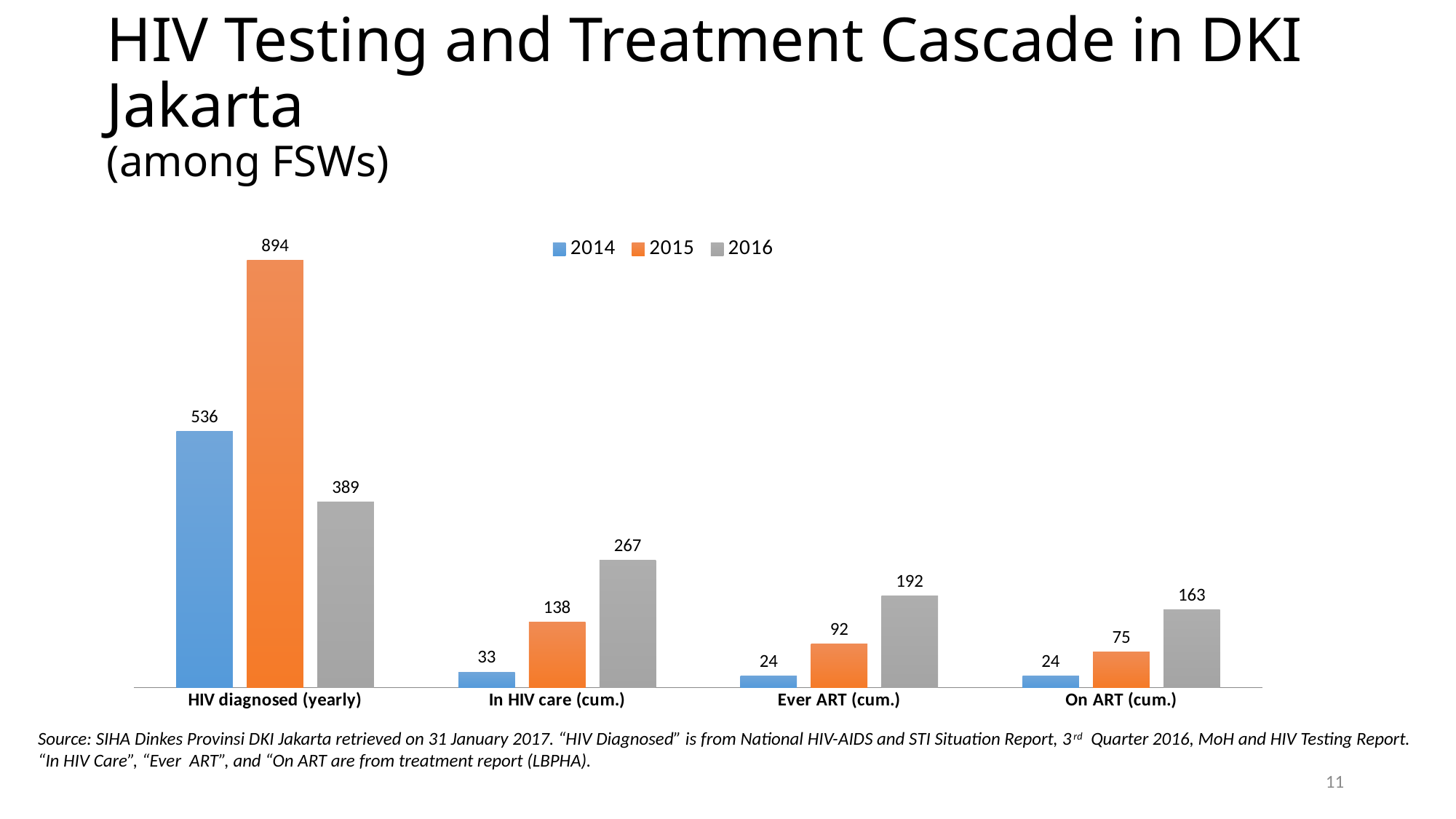
What is the value for 2016 in the In HIV care (cum.) category? 267 What is the difference between the 2015 and 2014 values in the HIV diagnosed (yearly) category? 358 What is the value for 2015 in the HIV diagnosed (yearly) category? 894 Which year has the lowest value in the Ever ART (cum.) category? 2014 How many categories are shown on the x axis? 4 What kind of chart is shown on the slide? Bar chart Which is larger: the 2016 value for In HIV care (cum.) or the 2016 value for Ever ART (cum.)? In HIV care (cum.) Do the 2016 values rise or fall from In HIV care (cum.) to On ART (cum.) along the x axis? Fall What is the value for 2014 in the On ART (cum.) category? 24 What is the difference between the 2016 and 2015 values in the Ever ART (cum.) category? 100 Which year has the highest value in the HIV diagnosed (yearly) category? 2015 How many series does the legend list? 3